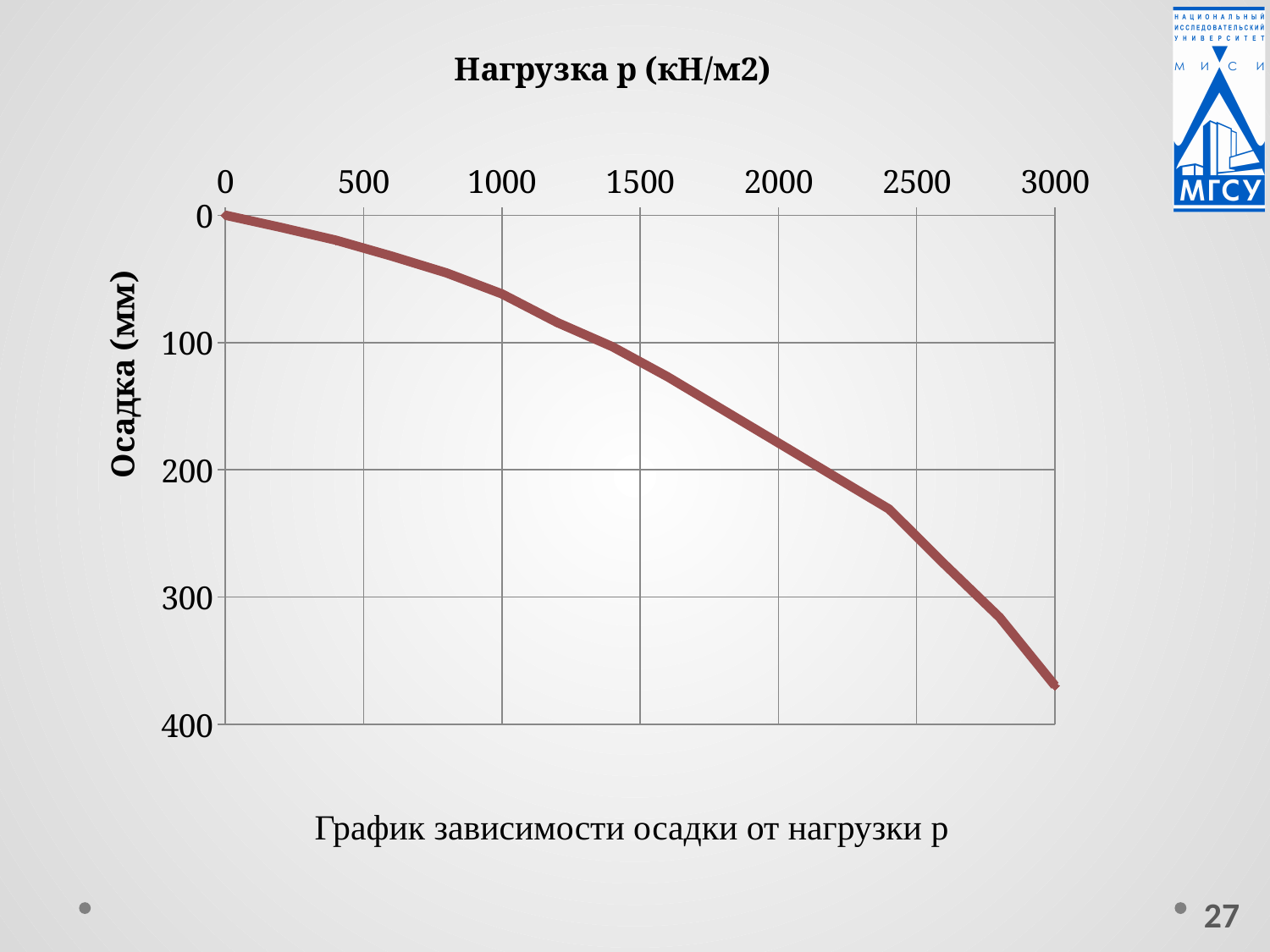
What is the settlement (Осадка) value at a load of 0 kN/m2? 0 Is the settlement at a load of 1500 kN/m2 greater or less than 100 mm? greater What is the label of the vertical axis? Осадка (мм) Is the settlement at a load of 3000 kN/m2 greater or less than 300 mm? greater What is the title shown above the chart? Нагрузка p (кН/м2) Is the settlement at a load of 1000 kN/m2 greater or less than 100 mm? less At which load value shown on the x axis is the settlement the largest? 3000 What kind of chart is shown on the slide? line chart Does the settlement increase or decrease as the load p increases along the x axis? increases